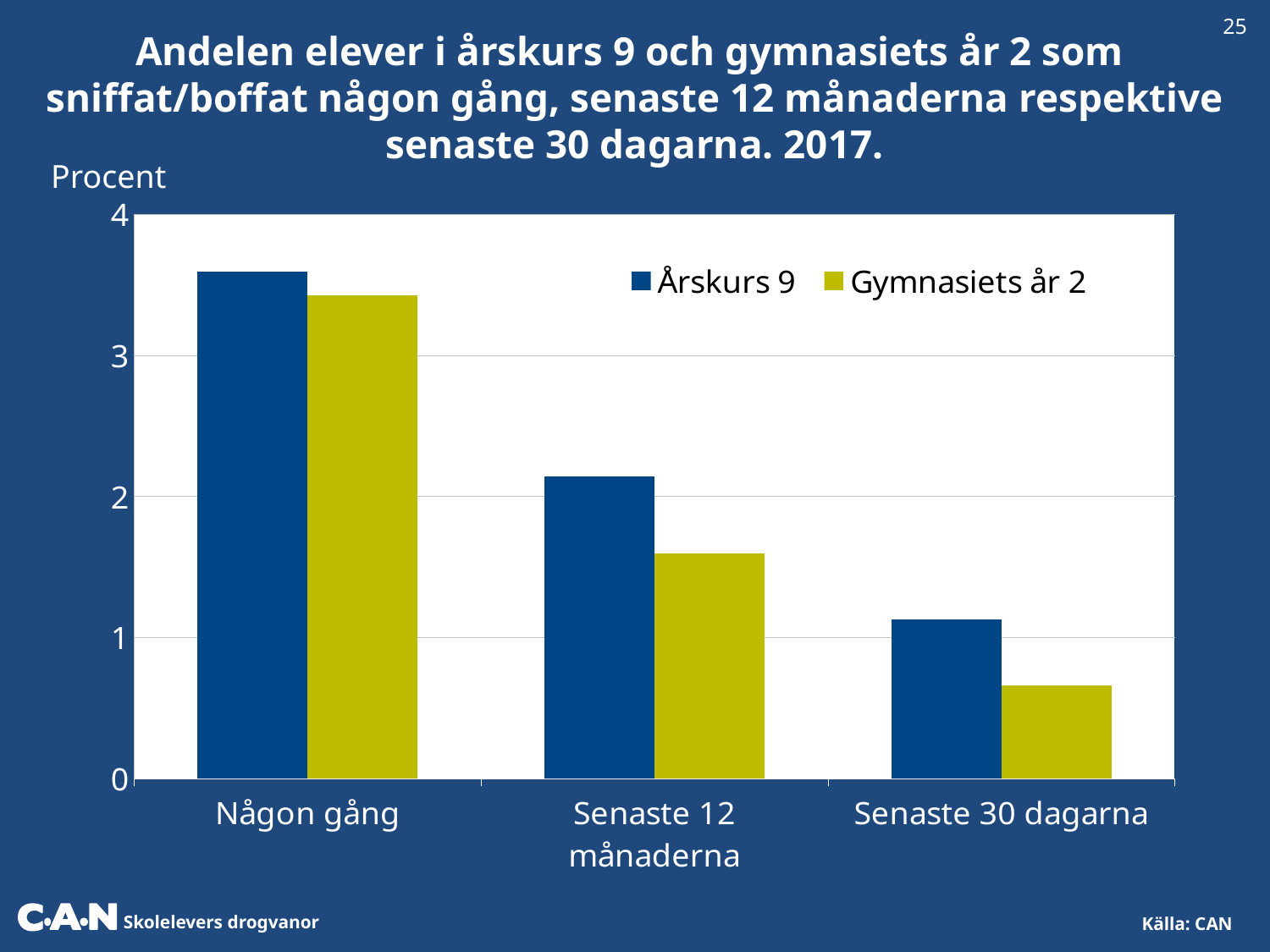
Which series does the legend list first? Årskurs 9 For Senaste 12 månaderna, which series has the larger value, Årskurs 9 or Gymnasiets år 2? Årskurs 9 How many series does the legend list? 2 Is the value for Årskurs 9 in Någon gång greater or less than 3? greater Is the value for Gymnasiets år 2 in Senaste 12 månaderna greater or less than 2? less Do the values for Årskurs 9 rise or fall from Någon gång to Senaste 30 dagarna? fall Which category has the lowest value for Gymnasiets år 2? Senaste 30 dagarna What kind of chart is shown on the slide? bar chart How many categories are shown on the x axis? 3 Which category has the highest value for Årskurs 9? Någon gång What is the label of the y axis? Procent Is the value for Gymnasiets år 2 in Senaste 30 dagarna greater or less than 1? less